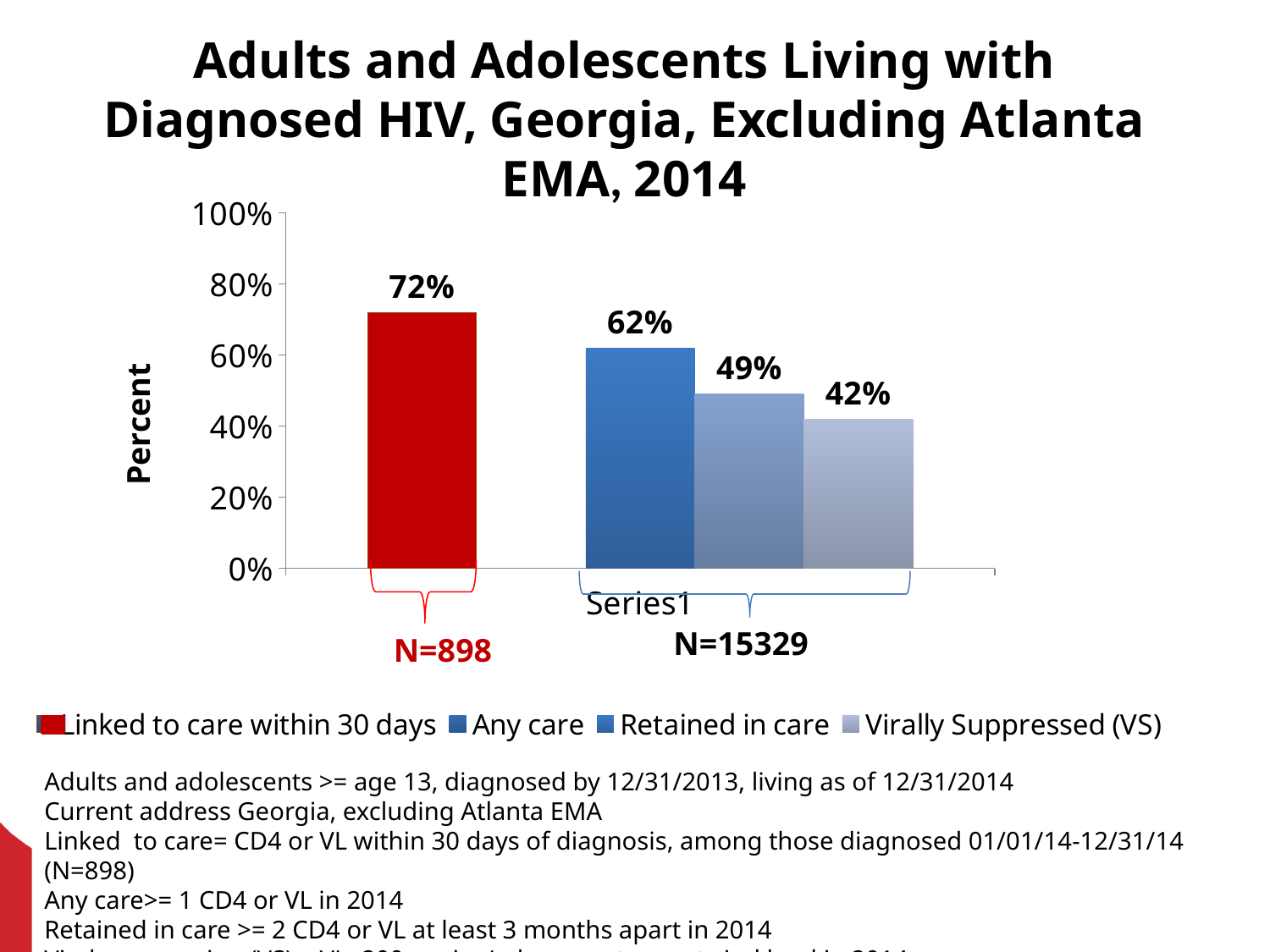
What is the N shown under the red bar? N=898 What percentage is shown for Retained in care? 49% What is the difference between the Any care value and the Virally Suppressed (VS) value? 20% What percentage is shown for Any care? 62% What kind of chart is shown on the slide? Bar chart Which series has the lowest value? Virally Suppressed (VS) What is the difference between the Linked to care within 30 days value and the Retained in care value? 23% Which series has the highest value? Linked to care within 30 days Which is larger, the value for Any care or the value for Retained in care? Any care What percentage is shown for Virally Suppressed (VS)? 42% What percentage is shown for Linked to care within 30 days? 72% How many series does the legend list? 4